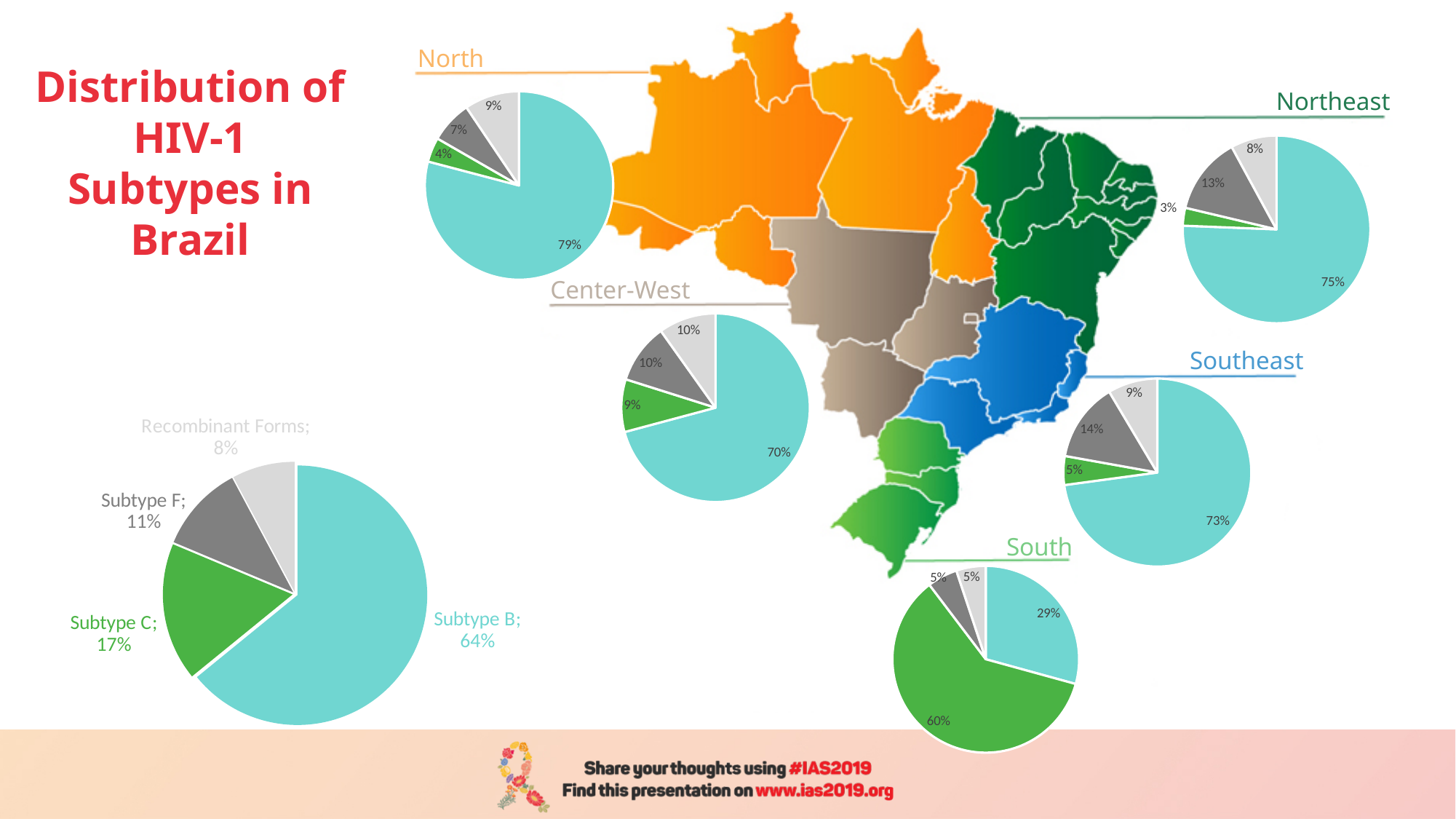
What kind of chart is used for each region on the slide? Pie chart In the South pie chart, what is the value of the largest (green) slice? 60% In the Northeast pie chart, what is the value of the smallest slice? 3% In the overall Brazil pie chart at the bottom left, what share is Recombinant Forms? 8% How many regional pie charts are placed around the map of Brazil? 5 In the overall Brazil pie chart at the bottom left, what share is Subtype C? 17% In the overall Brazil pie chart at the bottom left, how many slices are there? 4 In the overall Brazil pie chart at the bottom left, which subtype has the smallest share? Recombinant Forms In the overall Brazil pie chart at the bottom left, how many percentage points larger is Subtype C than Subtype F? 6 In the overall Brazil pie chart at the bottom left, what share is Subtype B? 64% Which is larger: the largest slice in the Southeast pie chart or the largest slice in the Center-West pie chart? Southeast (73%) In the North pie chart, what is the value of the largest slice? 79%